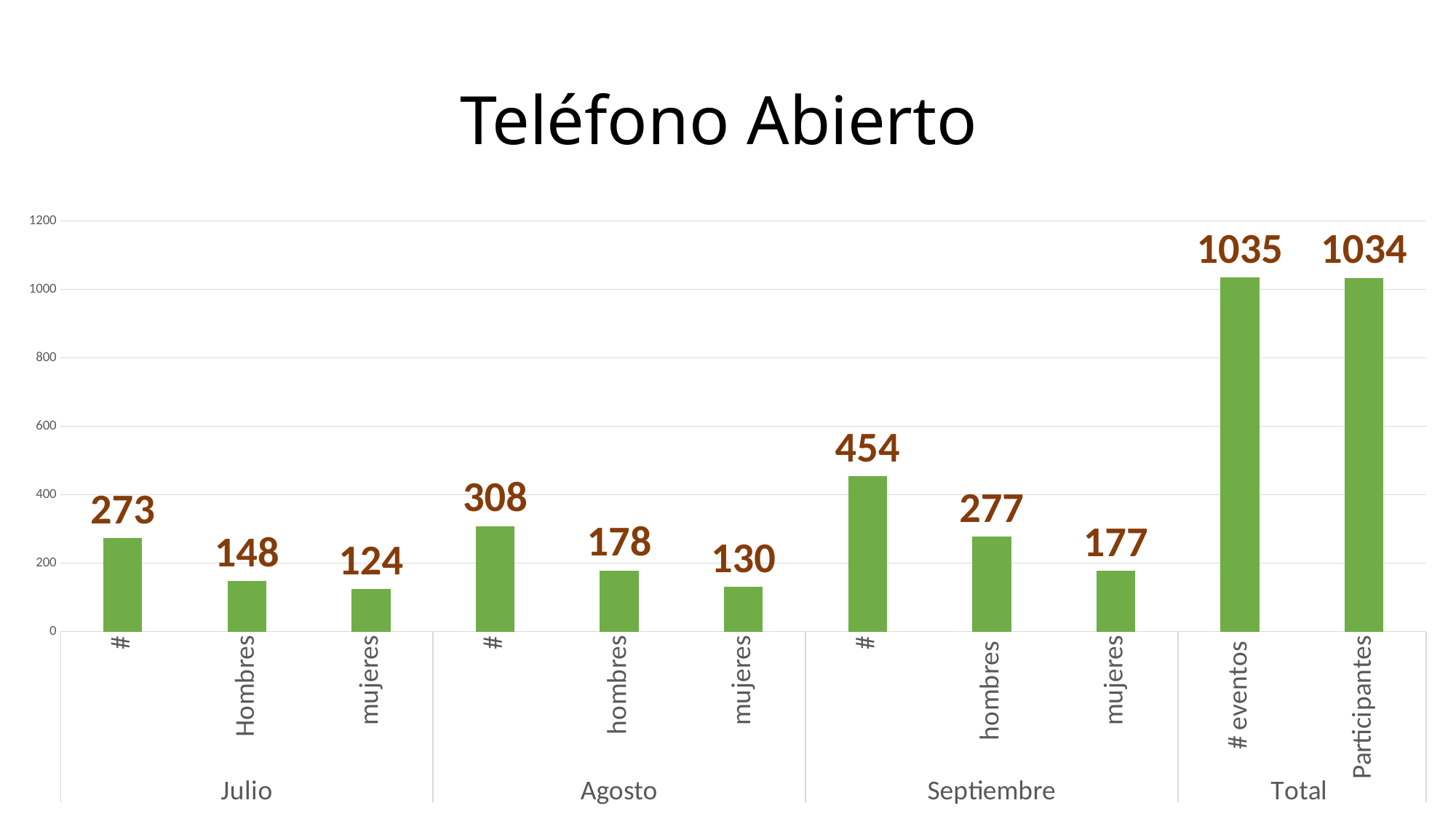
What is the value for Participantes in Total? 1034 How many bars are plotted in the chart? 11 Which bar has the highest value? # eventos (Total) What kind of chart is shown? bar chart What is the value for mujeres in Agosto? 130 Which bar has the lowest value? mujeres (Julio) What is the difference between # in Agosto and # in Julio? 35 What is the title of the chart? Teléfono Abierto What is the value for Hombres in Julio? 148 Which is larger, hombres in Agosto or mujeres in Septiembre? hombres in Agosto What is the difference between hombres and mujeres in Septiembre? 100 What is the value for # in Septiembre? 454